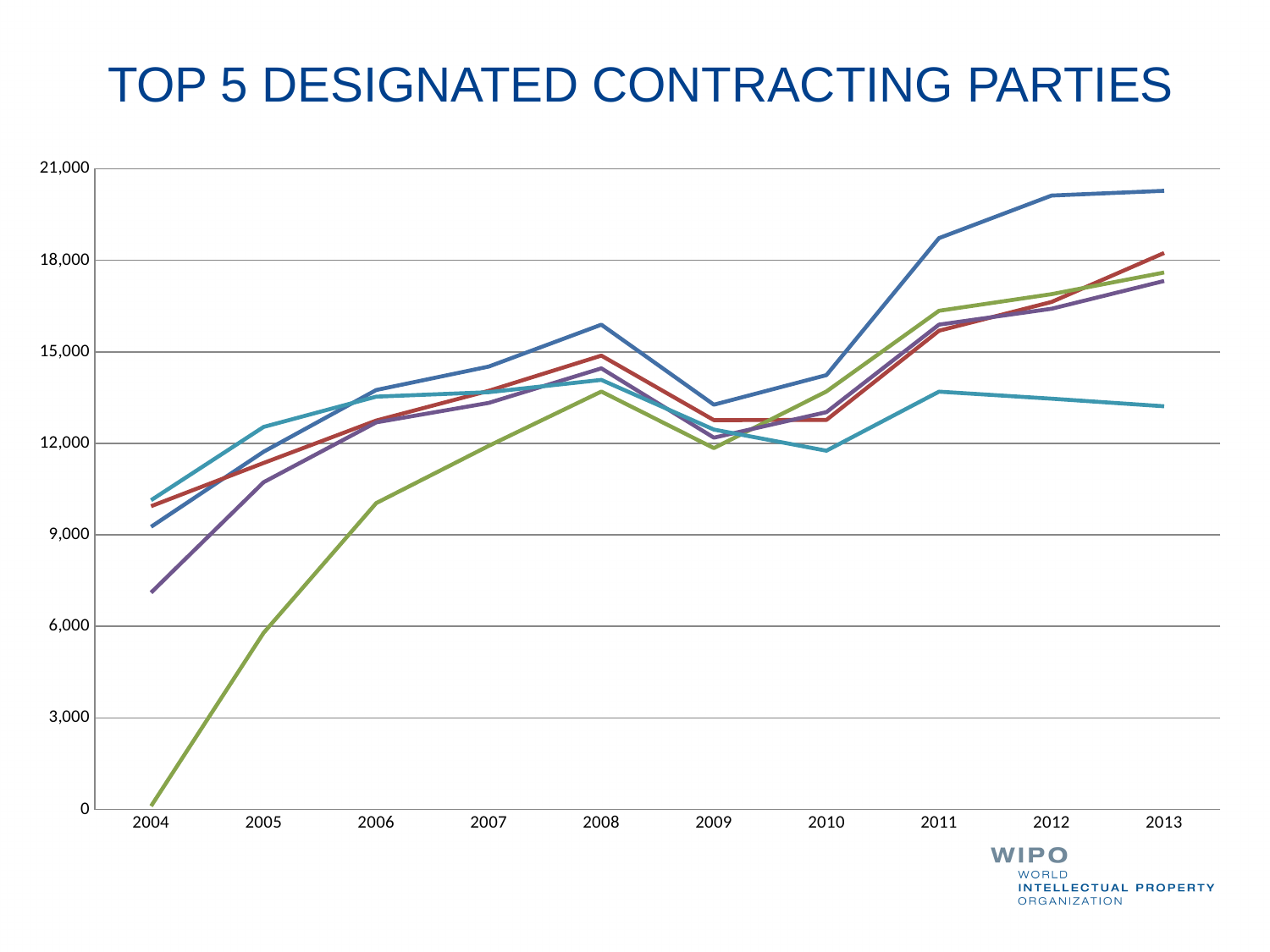
Is the value of the light blue line in 2013 greater or less than 15,000? less How many lines are plotted on the chart? 5 What kind of chart is shown on the slide? line chart How many years are shown along the x axis of the chart? 10 Is the value of the dark blue line in 2013 greater or less than 18,000? greater Which line has the lowest value in 2004? the green line In 2004, which is larger: the value of the purple line or the value of the green line? the purple line Which line has the lowest value in 2013? the light blue line Does the dark blue line rise or fall overall from 2004 to 2013? rise Which line has the highest value in 2013? the dark blue line Is the value of the green line in 2005 greater or less than 9,000? less What is the title of the chart? TOP 5 DESIGNATED CONTRACTING PARTIES